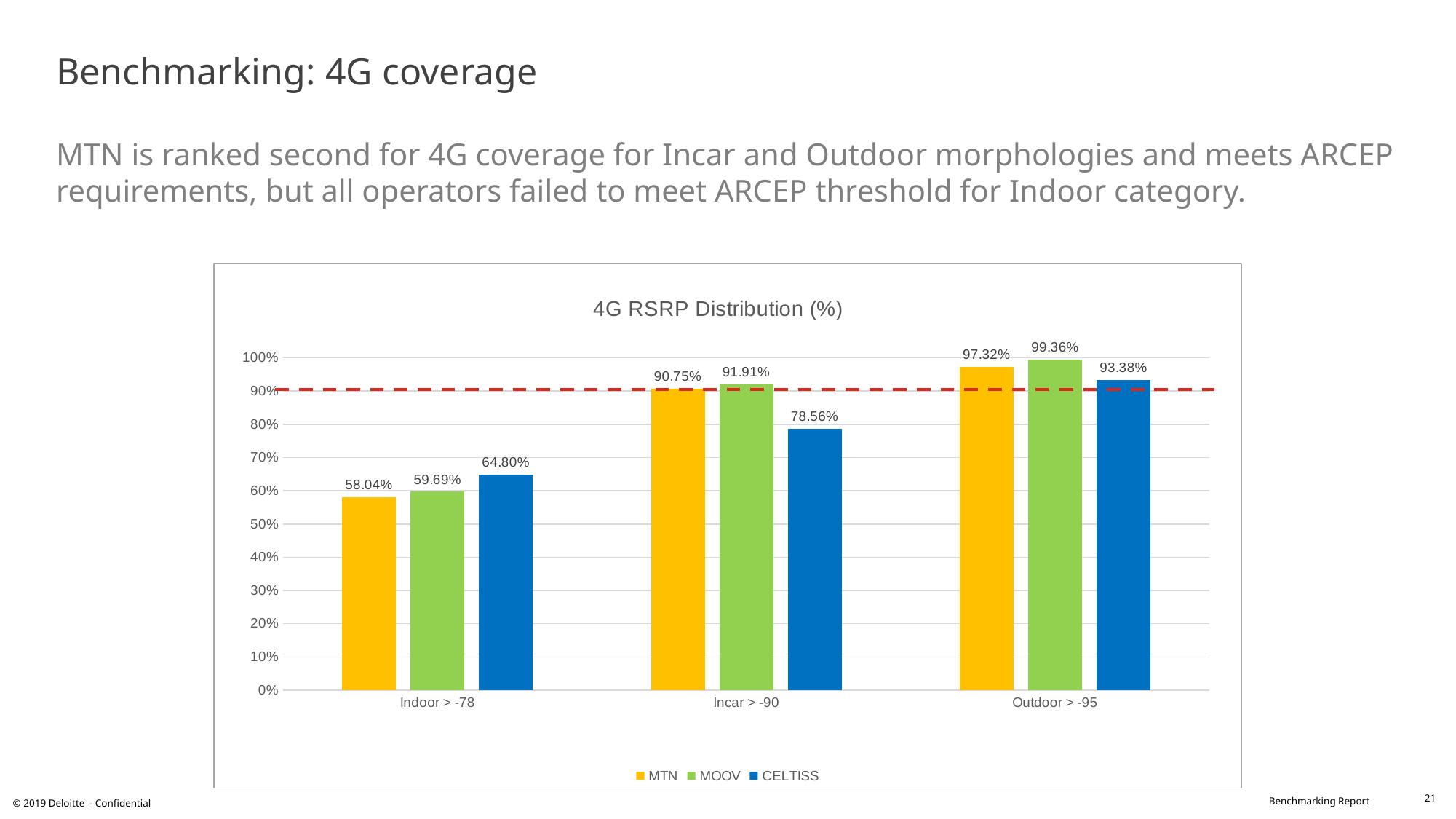
Is the value for CELTISS in the Indoor > -78 category greater or less than 70%? less What is the value for MTN in the Indoor > -78 category? 58.04% What is the value for MOOV in the Outdoor > -95 category? 99.36% What is the value for CELTISS in the Incar > -90 category? 78.56% Which operator has the highest value in the Outdoor > -95 category? MOOV What is the difference between MOOV and MTN in the Incar > -90 category? 1.16% What kind of chart is shown on the slide? bar chart Which is larger in the Incar > -90 category: MTN or CELTISS? MTN What is the title of the chart? 4G RSRP Distribution (%) How many categories are shown on the x axis? 3 Which operator has the lowest value in the Indoor > -78 category? MTN How many series does the legend list? 3